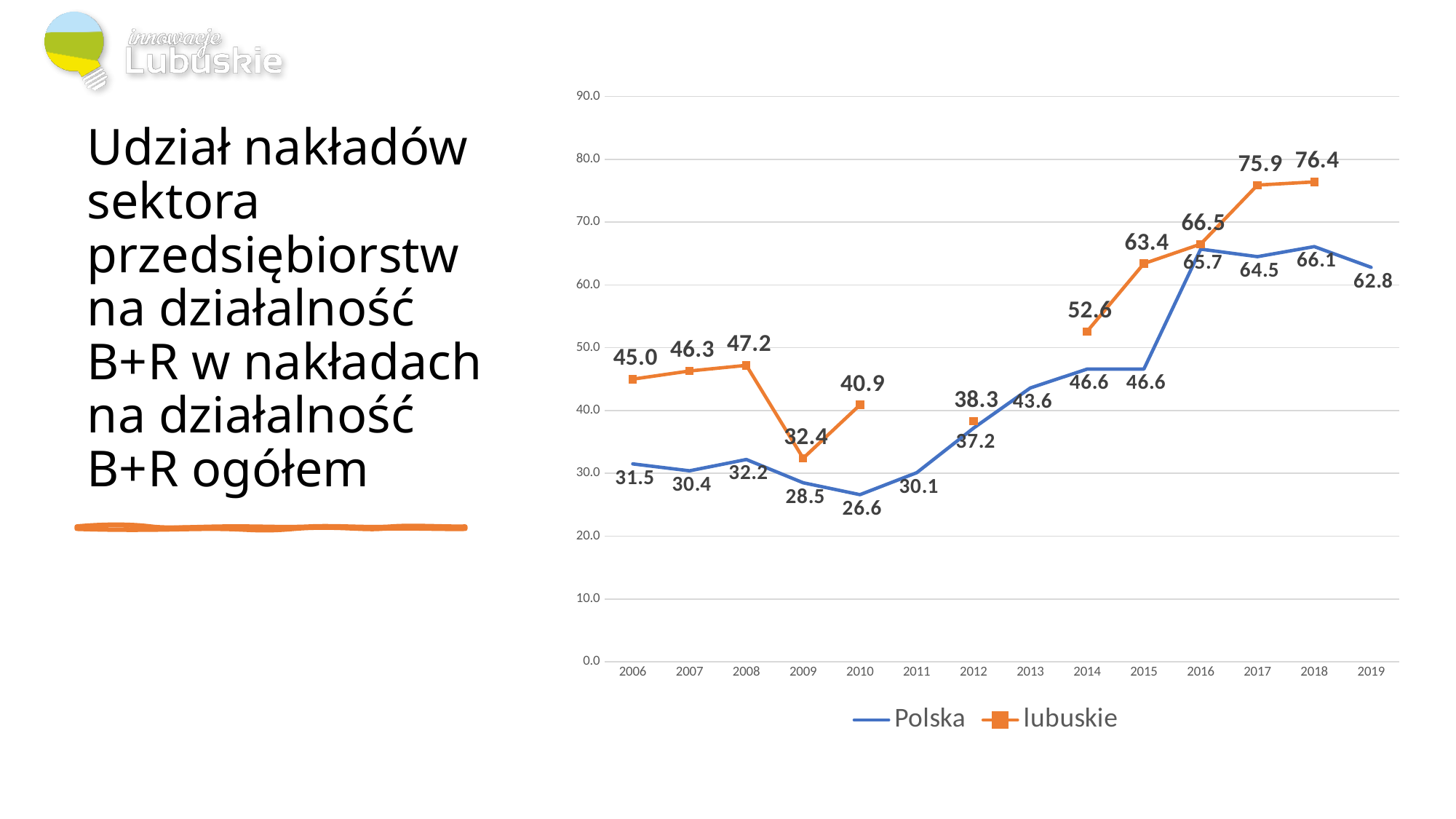
Is the value for Polska in 2016 greater or less than 60.0? greater In which year does the Polska series reach its lowest value? 2010 How many series does the legend list? 2 What is the value for lubuskie in 2009? 32.4 Which series has the larger value in 2014, Polska or lubuskie? lubuskie What is the value for Polska in 2010? 26.6 What is the value for Polska in 2019? 62.8 What is the value for lubuskie in 2018? 76.4 How many years are shown on the x axis? 14 In which year does the lubuskie series reach its highest value? 2018 What kind of chart is shown on the slide? line chart What is the difference between the lubuskie and Polska values in 2017? 11.4